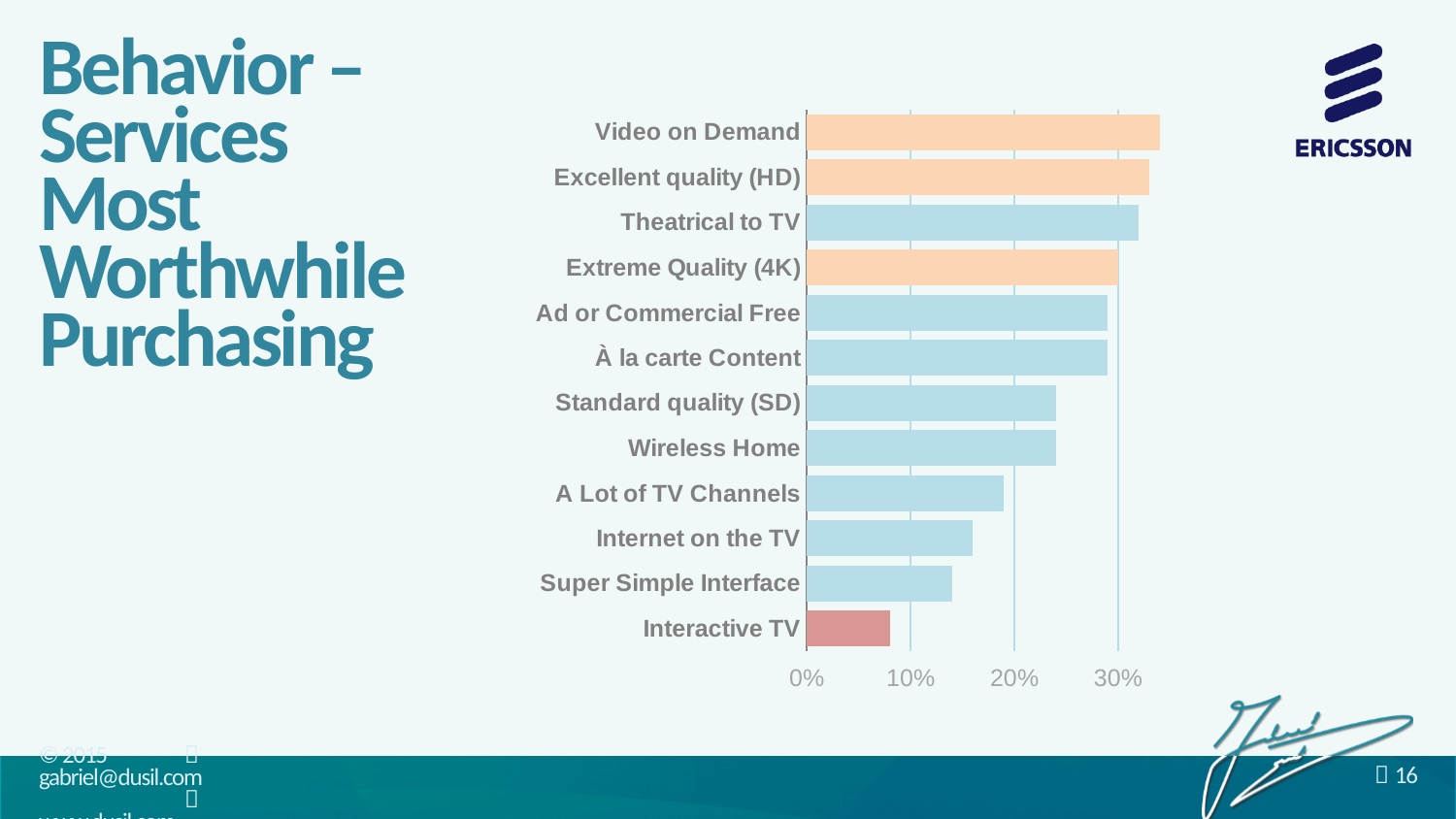
Is the value for Interactive TV greater or less than 10%? less Do the bar values increase or decrease going from the top category to the bottom category? decrease Which is larger, the value for Theatrical to TV or the value for Wireless Home? Theatrical to TV Which category has the lowest value in the chart? Interactive TV Is the value for Standard quality (SD) greater or less than 20%? greater Which category's bar is coloured red in the chart? Interactive TV Is the value for Video on Demand greater or less than 30%? greater Which category has the highest value in the chart? Video on Demand What kind of chart is shown on the slide? bar chart How many categories are plotted in the chart? 12